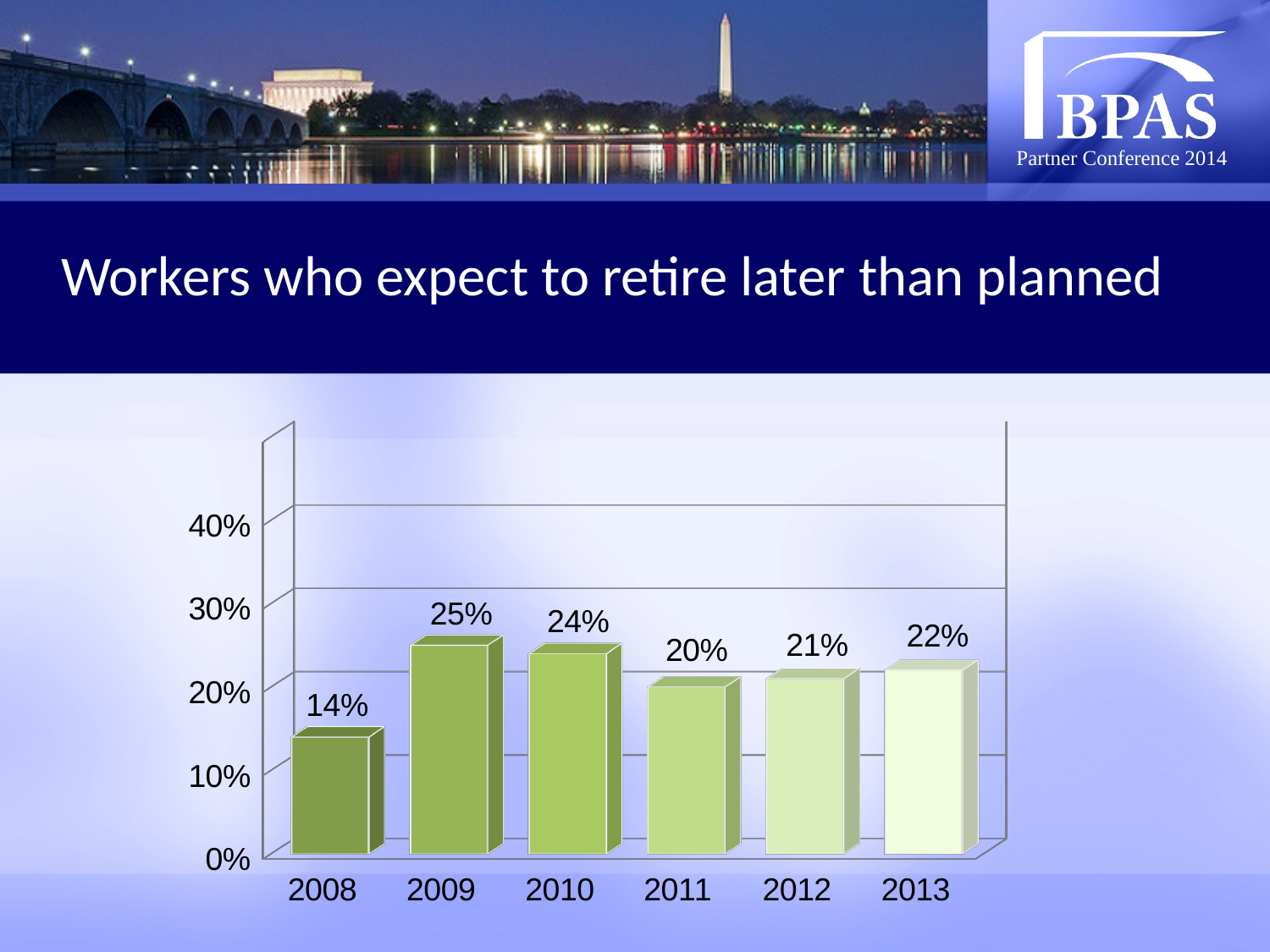
What is the difference between the values for 2010 and 2011? 4% What is the title of the slide containing the chart? Workers who expect to retire later than planned What is the difference between the 2009 value and the 2008 value? 11% What percentage of workers expected to retire later than planned in 2008? 14% How many years are shown on the x axis of the chart? 6 Which is larger, the value for 2010 or the value for 2012? 2010 What is the value shown for 2011? 20% What is the value shown for 2013? 22% Which year has the highest percentage of workers expecting to retire later than planned? 2009 Which year has the lowest value on the chart? 2008 What kind of chart is shown on the slide? Bar chart Is the value for 2009 greater or less than 20%? greater